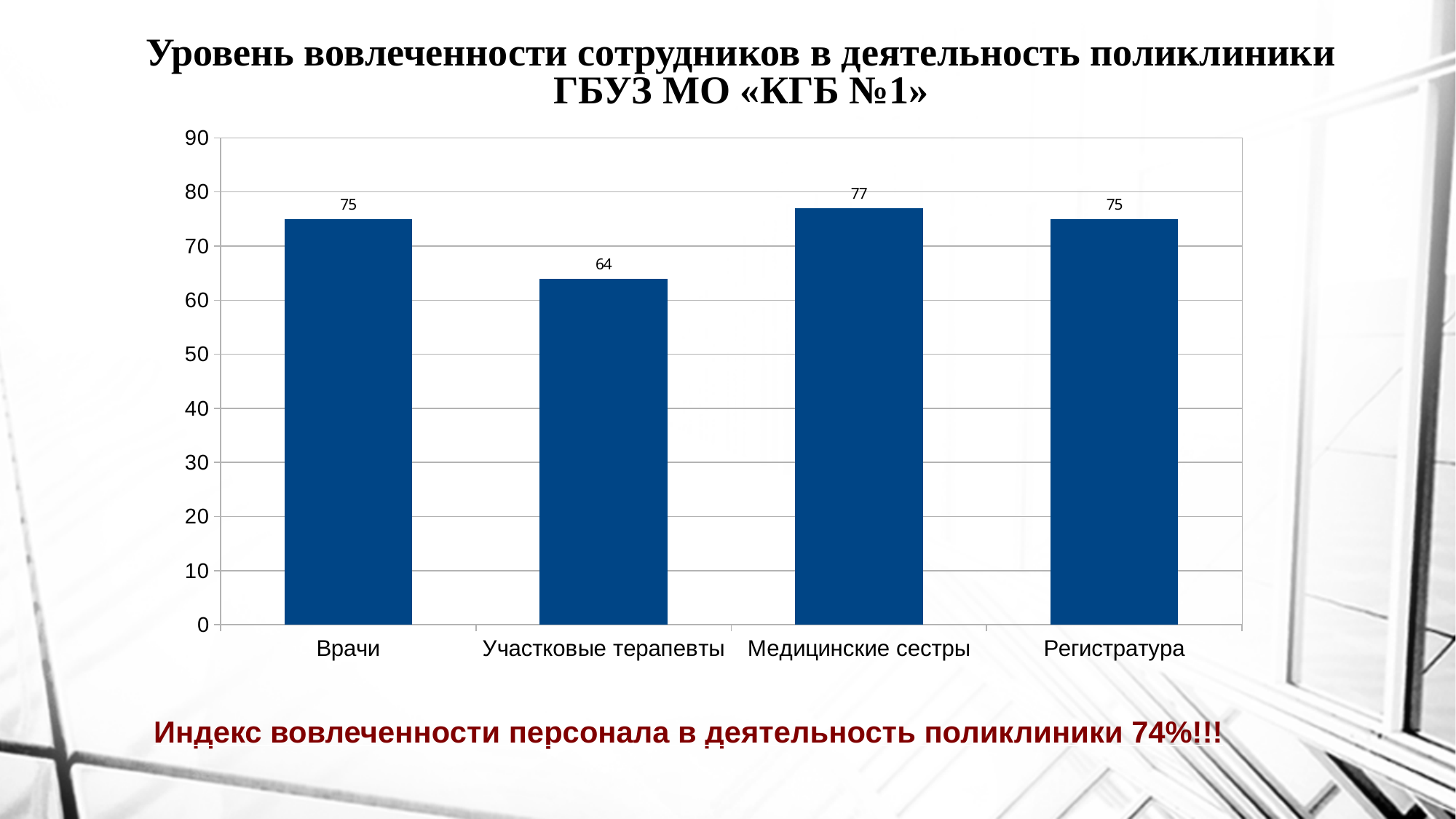
What is the value for Регистратура? 75 Which category has the lowest value? Участковые терапевты What is the difference between the values for Медицинские сестры and Участковые терапевты? 13 What is the value for Медицинские сестры? 77 Which category has the highest value? Медицинские сестры What kind of chart is shown on the slide? bar chart Is the value for Участковые терапевты greater or less than 70? less What is the value for Врачи? 75 How many categories are shown on the x axis? 4 What is the highest value shown on the vertical axis? 90 Which is larger, the value for Врачи or the value for Участковые терапевты? Врачи What is the value for Участковые терапевты? 64